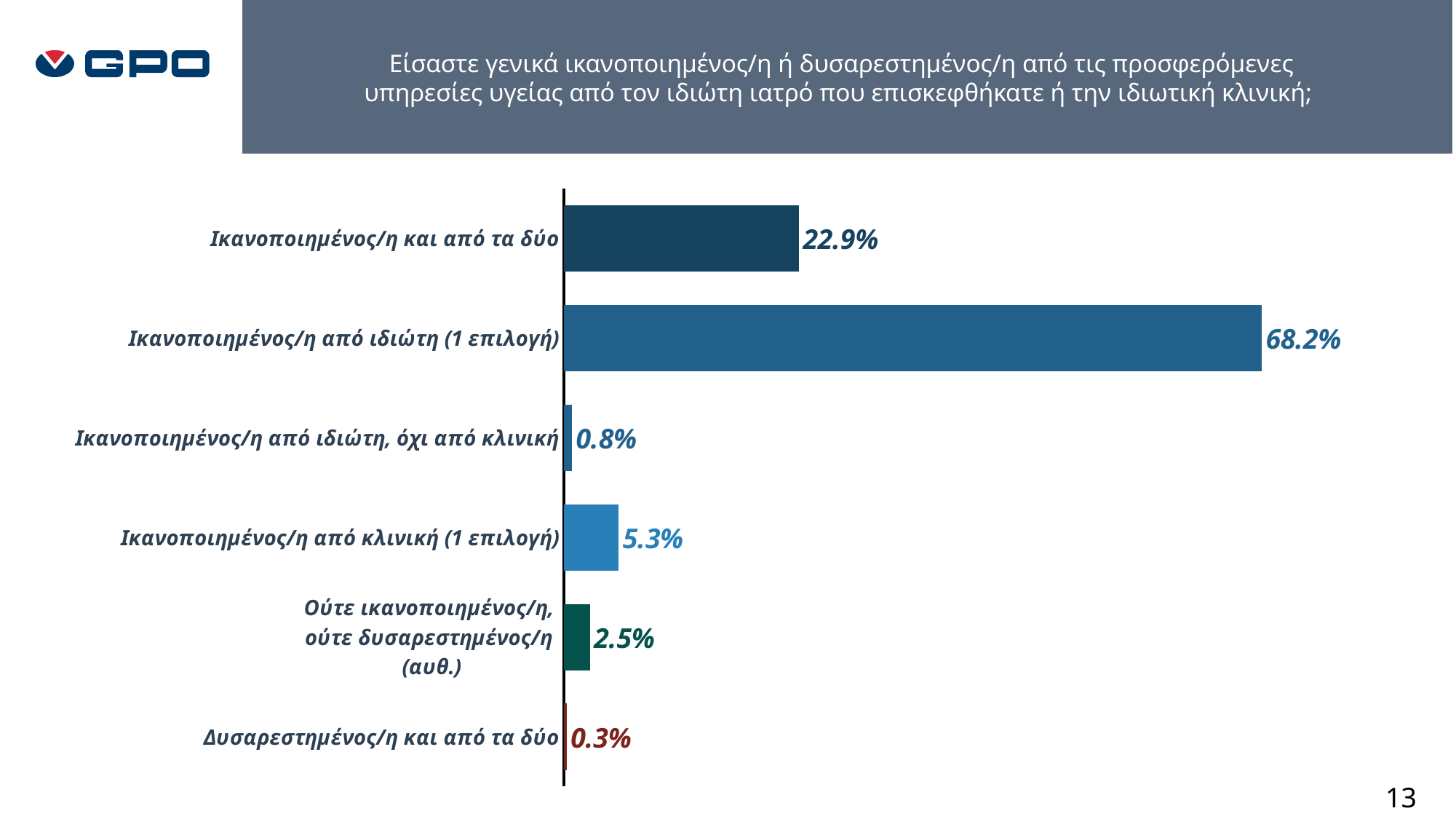
What is the value for "Ικανοποιημένος/η και από τα δύο"? 22.9% What is the value for "Δυσαρεστημένος/η και από τα δύο"? 0.3% How many categories are shown in the chart? 6 What is the value for "Ικανοποιημένος/η από ιδιώτη (1 επιλογή)"? 68.2% What is the difference between "Ικανοποιημένος/η από ιδιώτη (1 επιλογή)" and "Ικανοποιημένος/η και από τα δύο"? 45.3% What is the value for "Ικανοποιημένος/η από κλινική (1 επιλογή)"? 5.3% Which category has the highest value? Ικανοποιημένος/η από ιδιώτη (1 επιλογή) What is the difference between "Ικανοποιημένος/η από κλινική (1 επιλογή)" and "Ικανοποιημένος/η από ιδιώτη, όχι από κλινική"? 4.5% What kind of chart is shown on the slide? Bar chart What colour is the bar for "Δυσαρεστημένος/η και από τα δύο"? Red Which category has the lowest value? Δυσαρεστημένος/η και από τα δύο Which is larger: "Ικανοποιημένος/η από κλινική (1 επιλογή)" or "Ούτε ικανοποιημένος/η, ούτε δυσαρεστημένος/η (αυθ.)"? Ικανοποιημένος/η από κλινική (1 επιλογή)